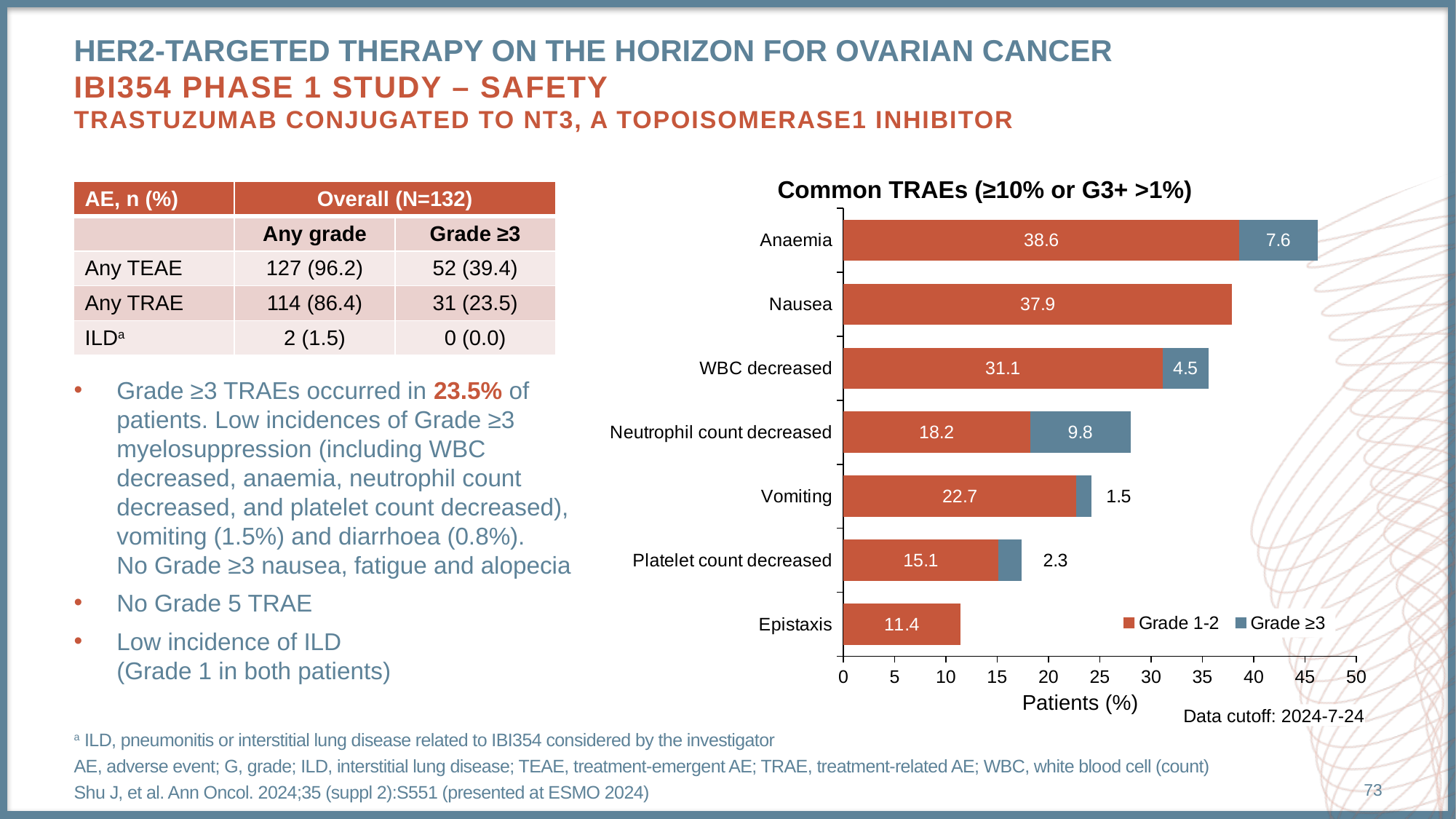
What is the title of the chart? Common TRAEs (≥10% or G3+ >1%) How many TRAE categories are shown in the chart? 7 How many series does the legend list? 2 What is the Grade 1-2 value for Anaemia? 38.6 What is the total (Grade 1-2 plus Grade ≥3) for Anaemia? 46.2 What is the Grade ≥3 value for Neutrophil count decreased? 9.8 Which has a larger Grade ≥3 value, Anaemia or WBC decreased? Anaemia What type of chart is shown on the slide? Stacked bar chart What is the difference between the Grade 1-2 values for Vomiting and Platelet count decreased? 7.6 Which TRAE has the highest Grade ≥3 value? Neutrophil count decreased What is the Grade 1-2 value for Epistaxis? 11.4 Which TRAE has the lowest Grade 1-2 value? Epistaxis